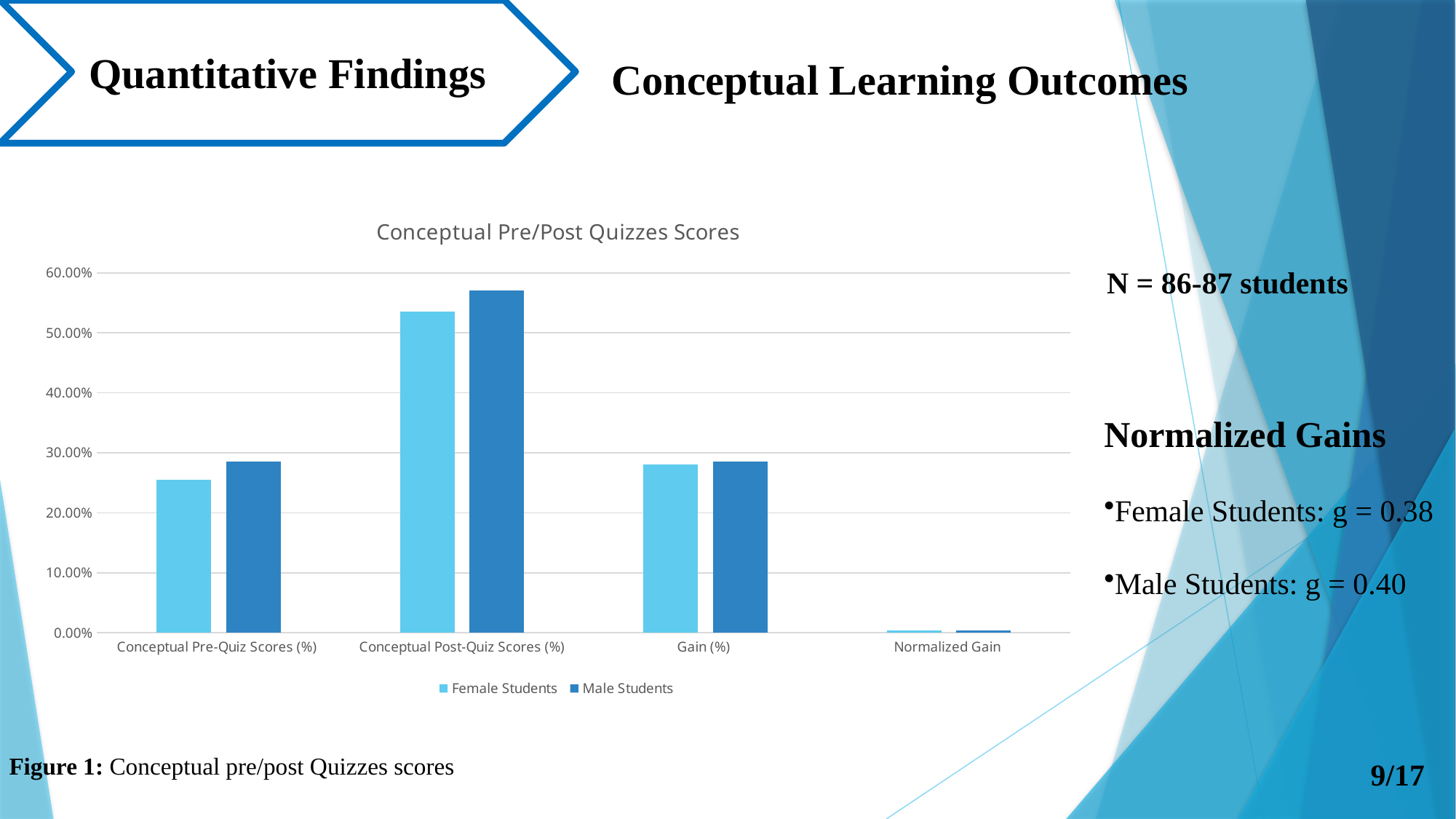
Is the Female Students value for Conceptual Post-Quiz Scores (%) greater or less than 50.00%? greater How many categories are shown along the x axis of the chart? 4 What kind of chart is shown on the slide? Bar chart Is the Female Students value for Conceptual Pre-Quiz Scores (%) greater or less than 20.00%? greater For Conceptual Post-Quiz Scores (%), which series has the larger value, Female Students or Male Students? Male Students Is the Male Students value for Conceptual Post-Quiz Scores (%) greater or less than 60.00%? less Which two series are listed in the chart legend? Female Students and Male Students Which category has the shortest bars in the chart? Normalized Gain How many series does the chart legend list? 2 For Conceptual Pre-Quiz Scores (%), which series has the larger value, Female Students or Male Students? Male Students Which category has the tallest bars in the chart? Conceptual Post-Quiz Scores (%) What is the title of the chart? Conceptual Pre/Post Quizzes Scores